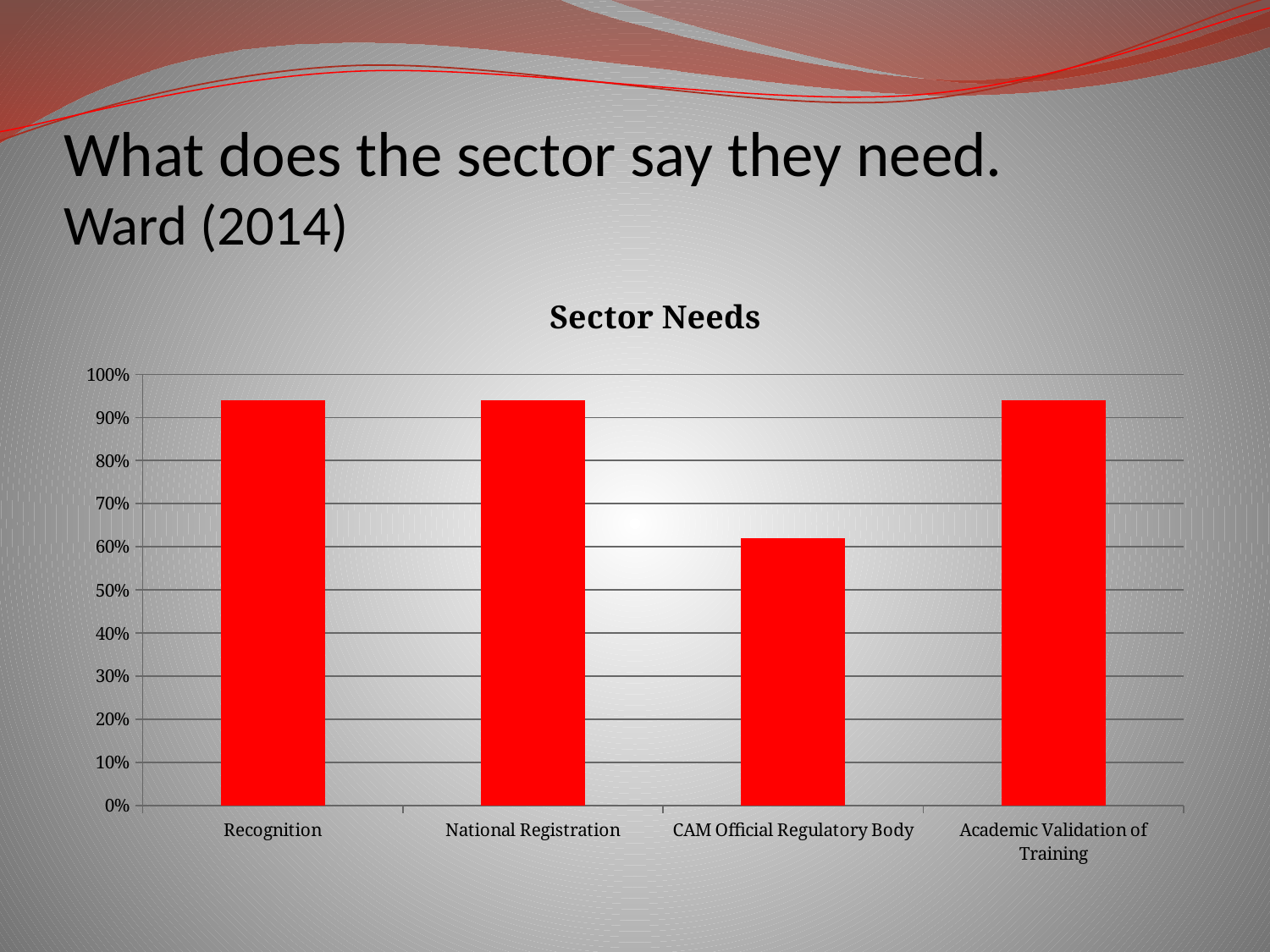
Which is larger, the value for Recognition or the value for CAM Official Regulatory Body? Recognition Is the value for CAM Official Regulatory Body greater or less than 50%? greater What kind of chart is shown on the slide? bar chart Is the value for CAM Official Regulatory Body greater or less than 70%? less How many categories are shown on the x axis of the chart? 4 Which category has the lowest value in the chart? CAM Official Regulatory Body Which is larger, the value for CAM Official Regulatory Body or the value for Academic Validation of Training? Academic Validation of Training Is the value for Academic Validation of Training greater or less than 90%? greater What colour are the bars in the chart? red What is the title of the chart? Sector Needs